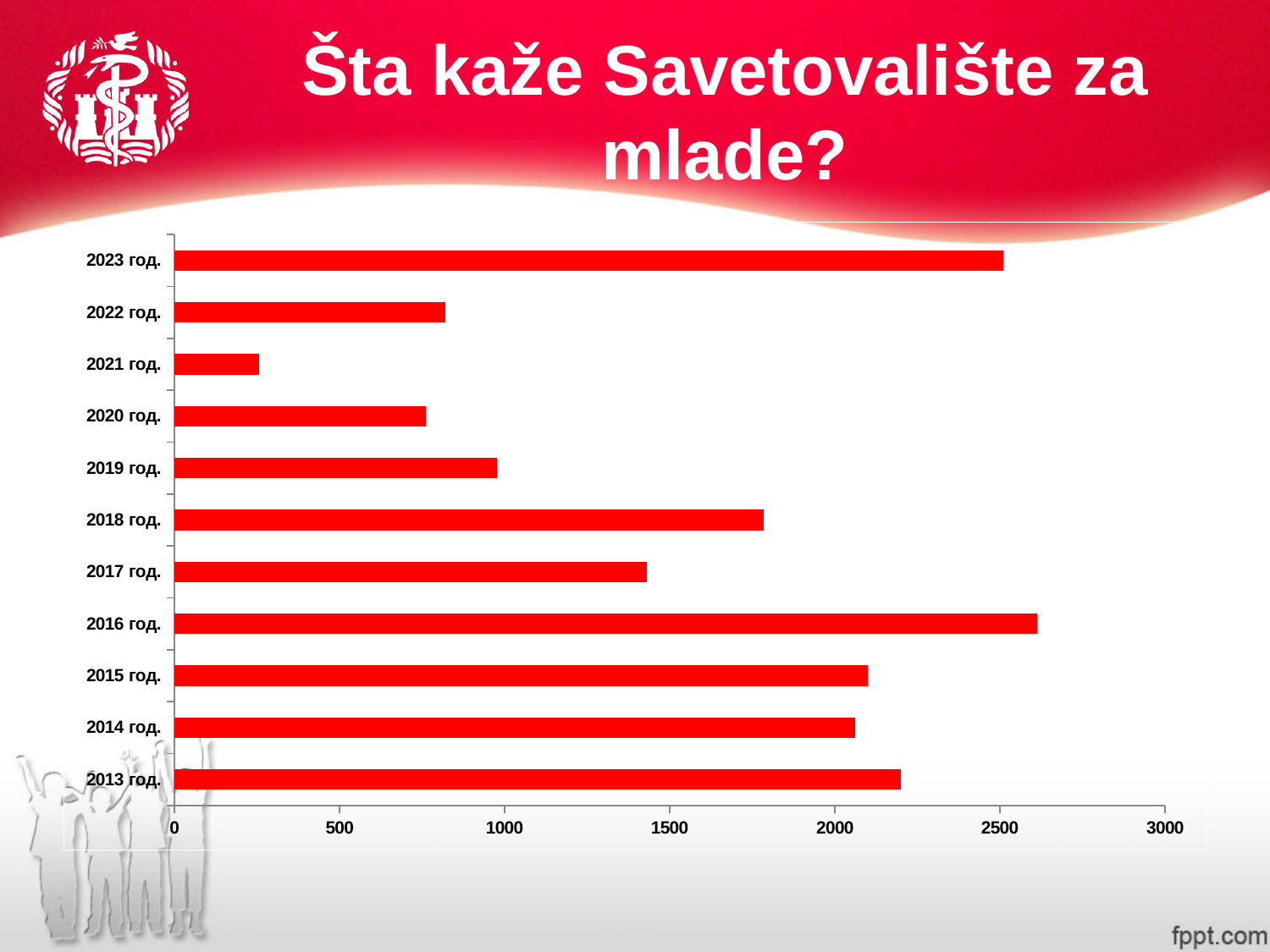
Is the value for 2021 год. greater or less than 500? less Which is larger, the value for 2018 год. or the value for 2017 год.? 2018 год. How many years (categories) are plotted in the chart? 11 Is the value for 2017 год. greater or less than 1500? less Which year has the highest value in the chart? 2016 год. Is the value for 2023 год. greater or less than 2000? greater Which is larger, the value for 2023 год. or the value for 2013 год.? 2023 год. What colour are the bars in the chart? red Which year has the lowest value in the chart? 2021 год. What kind of chart is shown on the slide? bar chart